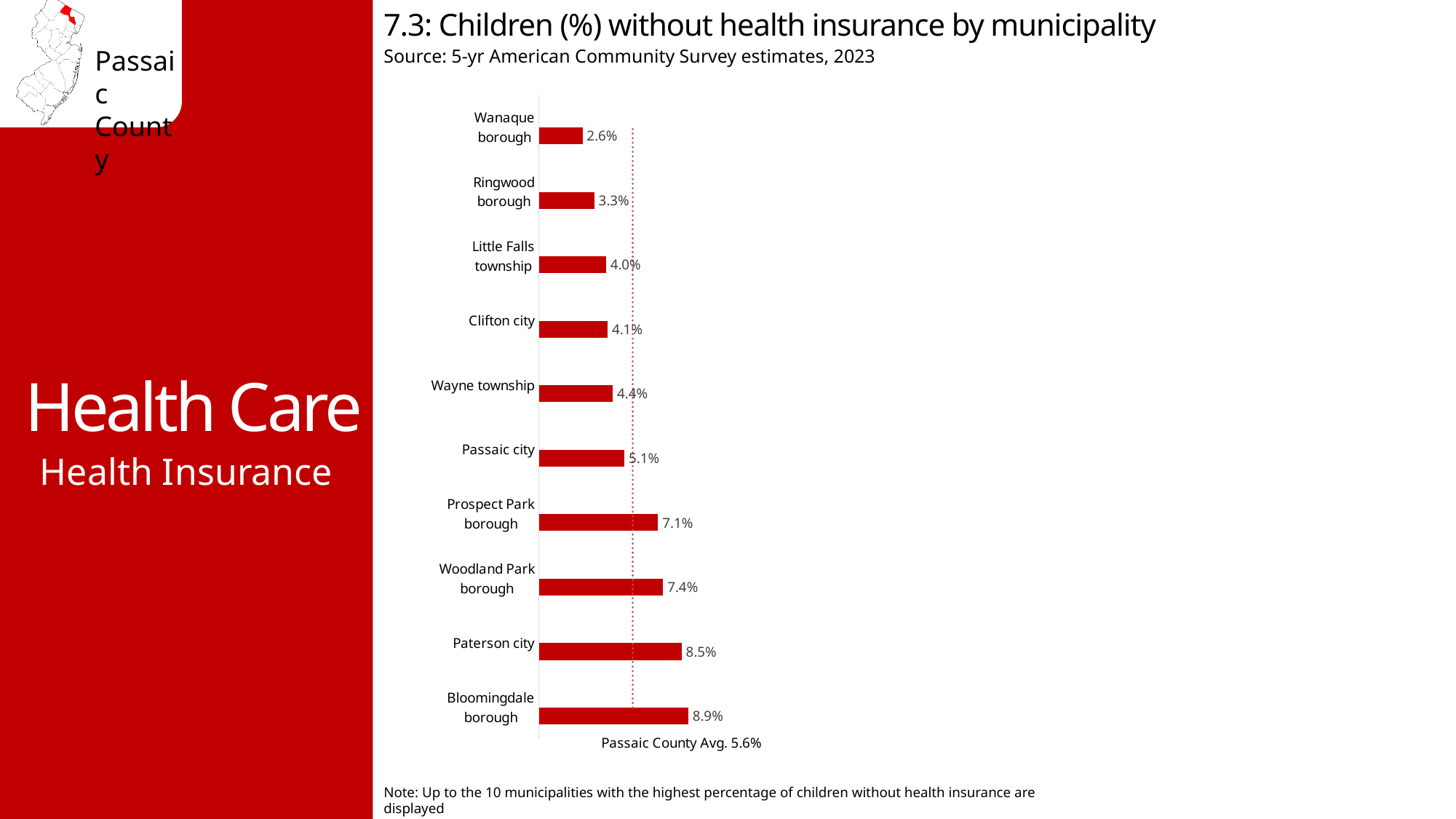
What is the Passaic County average shown on the chart? 5.6% Which municipality has the lowest percentage of children without health insurance? Wanaque borough What is the value shown for Prospect Park borough? 7.1% What is the difference between the values for Woodland Park borough and Passaic city? 2.3% What kind of chart is shown on the slide? Bar chart What is the difference between the values for Bloomingdale borough and Wanaque borough? 6.3% What percentage of children are without health insurance in Paterson city? 8.5% What is the value shown for Wayne township? 4.4% Which municipality has the highest percentage of children without health insurance? Bloomingdale borough What is the source of the data shown in the chart? 5-yr American Community Survey estimates, 2023 How many municipalities are shown in the chart? 10 Which has a higher value, Ringwood borough or Little Falls township? Little Falls township